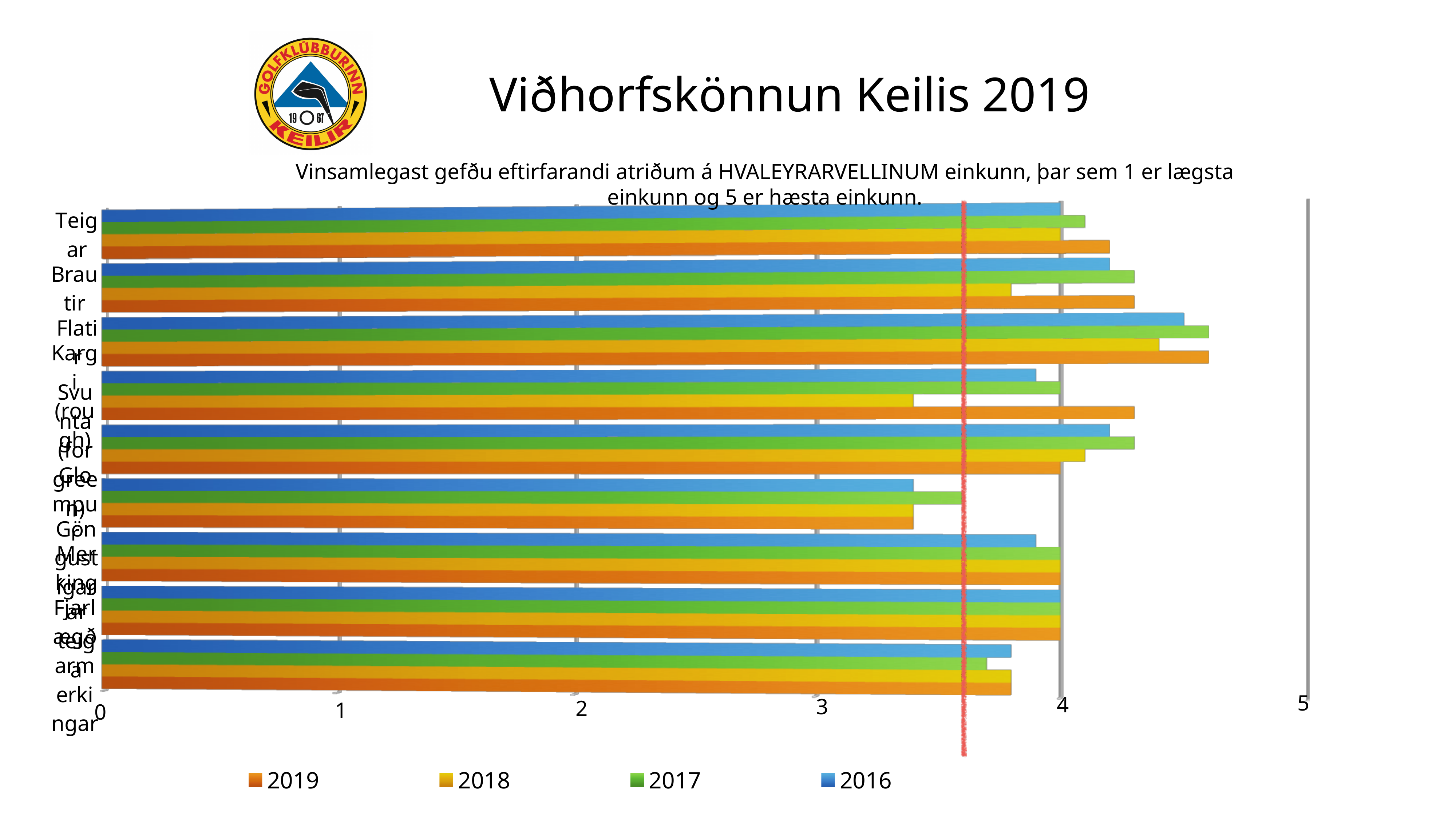
What kind of chart is shown on the slide? bar chart How many groups of bars (categories) are plotted in the chart? 9 Which has the larger 2019 value, Teigar or Flatir? Flatir Is the 2018 value for Flatir greater or less than 4? greater Is the 2019 value for Teigar greater or less than 4? greater Is the 2017 value for Brautir greater or less than 4? greater What is the highest value shown on the horizontal axis? 5 What is the title of the slide? Viðhorfskönnun Keilis 2019 Which years are listed in the chart legend? 2019, 2018, 2017, 2016 How many series does the legend list? 4